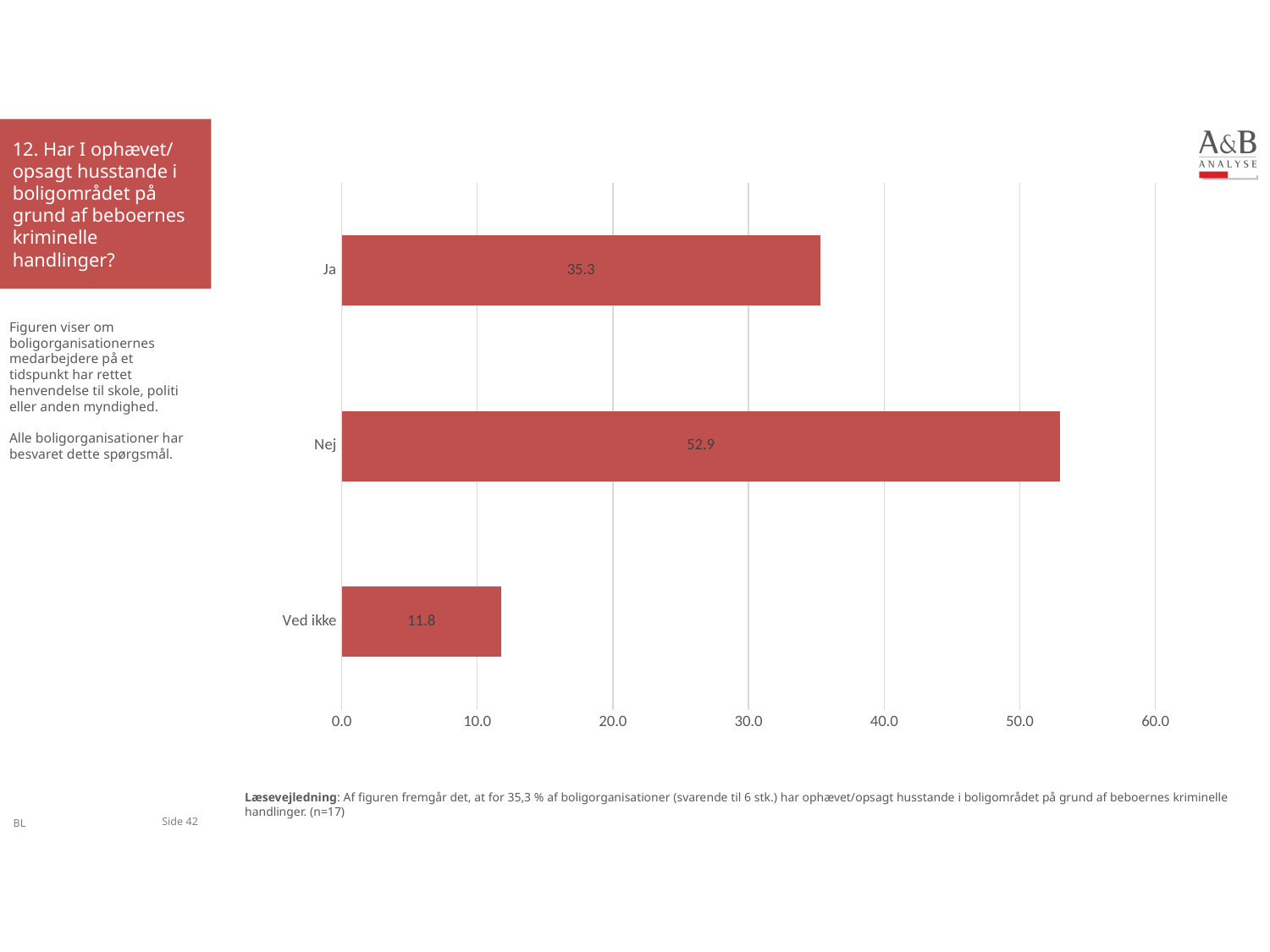
What kind of chart is shown on the slide? Bar chart Which category has the highest value? Nej Is the value for "Nej" greater or less than 50.0? greater How many categories are shown in the chart? 3 What is the difference between the values for "Nej" and "Ja"? 17.6 What is the difference between the values for "Ja" and "Ved ikke"? 23.5 Which category has the lowest value? Ved ikke What is the value for "Ved ikke"? 11.8 What is the value for "Ja"? 35.3 What is the value for "Nej"? 52.9 What is the highest value shown on the x axis? 60.0 Which is larger, the value for "Ja" or the value for "Ved ikke"? Ja